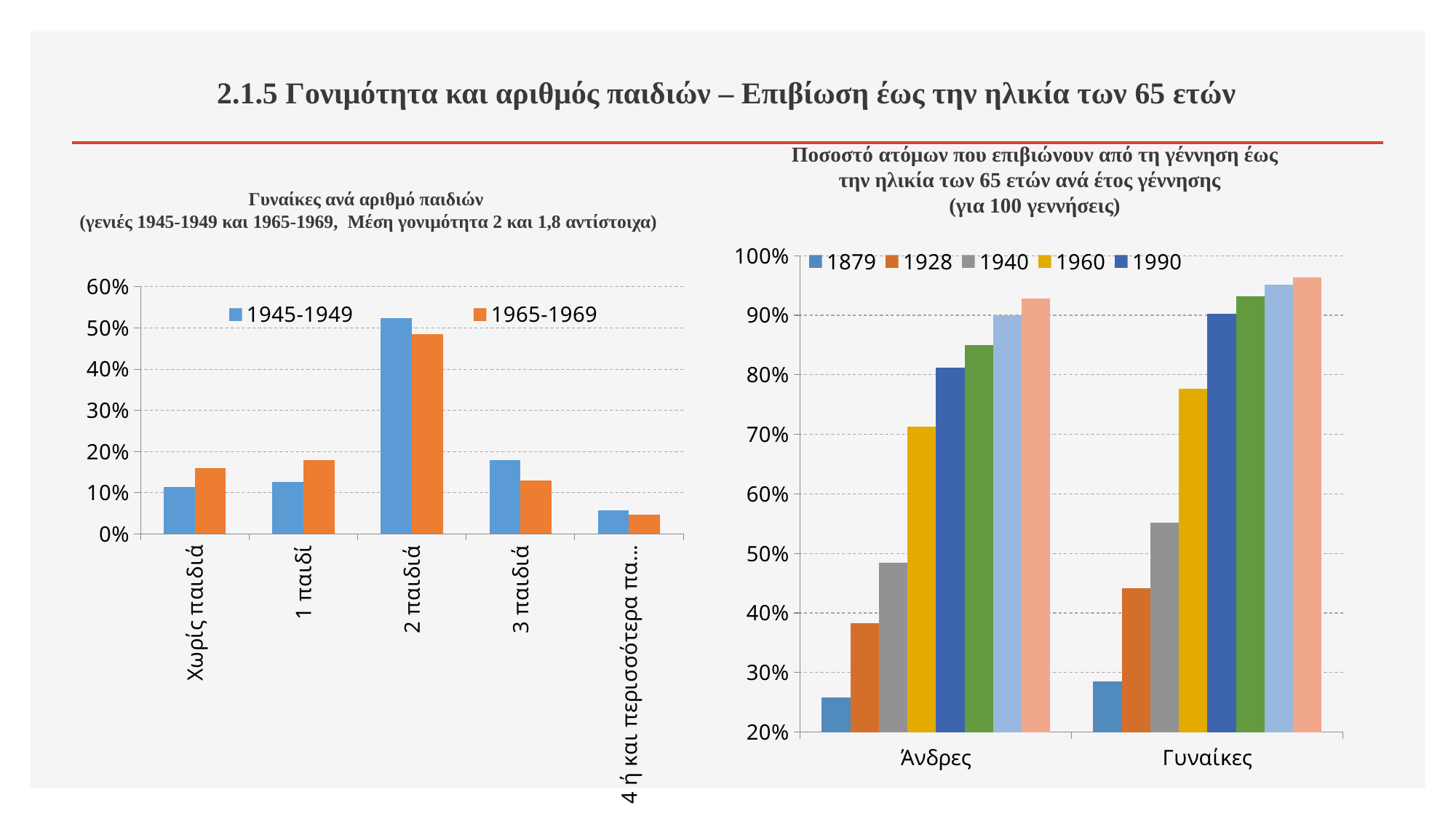
In the left chart, for 'Χωρίς παιδιά', which series has the larger value, 1945-1949 or 1965-1969? 1965-1969 In the left chart, which category has the lowest value for the 1965-1969 series? 4 ή και περισσότερα πα... How many categories are shown on the x axis of the left chart? 5 In the left chart, which category has the highest value for the 1945-1949 series? 2 παιδιά What kind of chart is the left chart, 'Γυναίκες ανά αριθμό παιδιών'? bar chart In the left chart, for '3 παιδιά', which series has the larger value, 1945-1949 or 1965-1969? 1945-1949 How many series does the legend of the left chart list? 2 In the right chart, for the 1928 series, which category has the larger value, 'Άνδρες' or 'Γυναίκες'? Γυναίκες In the left chart, is the 1945-1949 value for '2 παιδιά' greater or less than 40%? greater In the right chart, is the 1960 value for 'Γυναίκες' greater or less than 80%? less In the right chart, which series has the lowest value for 'Άνδρες'? 1879 In the right chart, is the 1940 value for 'Γυναίκες' greater or less than 50%? greater